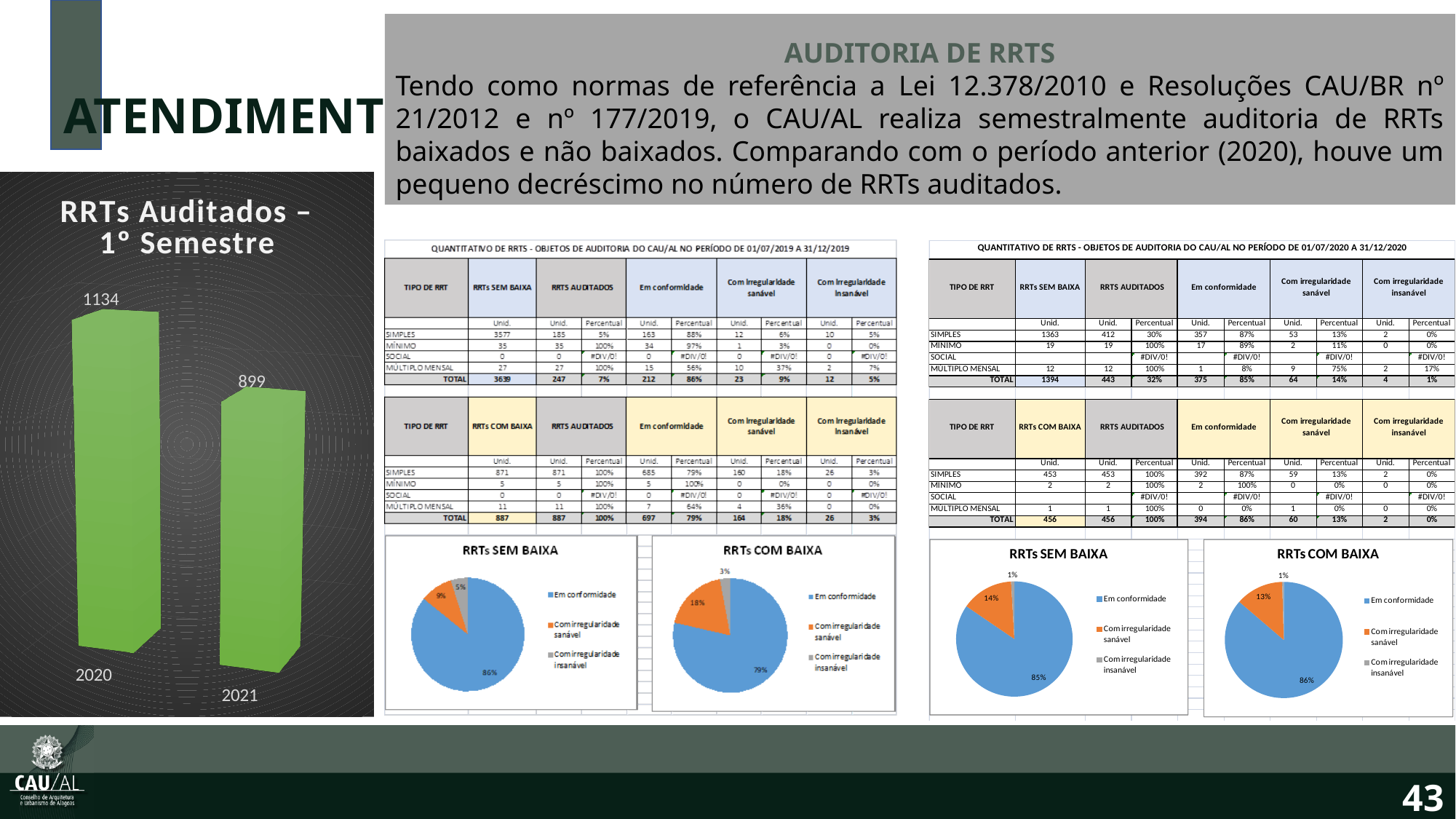
In the right-hand 'RRTs SEM BAIXA' pie chart (under the 2020 table), what share is 'Com irregularidade sanável'? 14% In the bar chart titled 'RRTs Auditados – 1° Semestre', how many bars are plotted? 2 In the bar chart titled 'RRTs Auditados – 1° Semestre', what is the value for 2020? 1134 In the bar chart titled 'RRTs Auditados – 1° Semestre', what is the difference between the 2020 and 2021 values? 235 What kind of chart is 'RRTs Auditados – 1° Semestre'? Bar chart In the bar chart titled 'RRTs Auditados – 1° Semestre', which year has the higher value? 2020 In the bar chart titled 'RRTs Auditados – 1° Semestre', what is the value for 2021? 899 How many entries does the legend of the right-hand 'RRTs COM BAIXA' pie chart list? 3 In the bar chart titled 'RRTs Auditados – 1° Semestre', do the values rise or fall from 2020 to 2021? Fall In the left-hand 'RRTs SEM BAIXA' pie chart (under the 2019 table), what share is 'Em conformidade'? 86% In the right-hand 'RRTs COM BAIXA' pie chart (under the 2020 table), what share is 'Em conformidade'? 86%